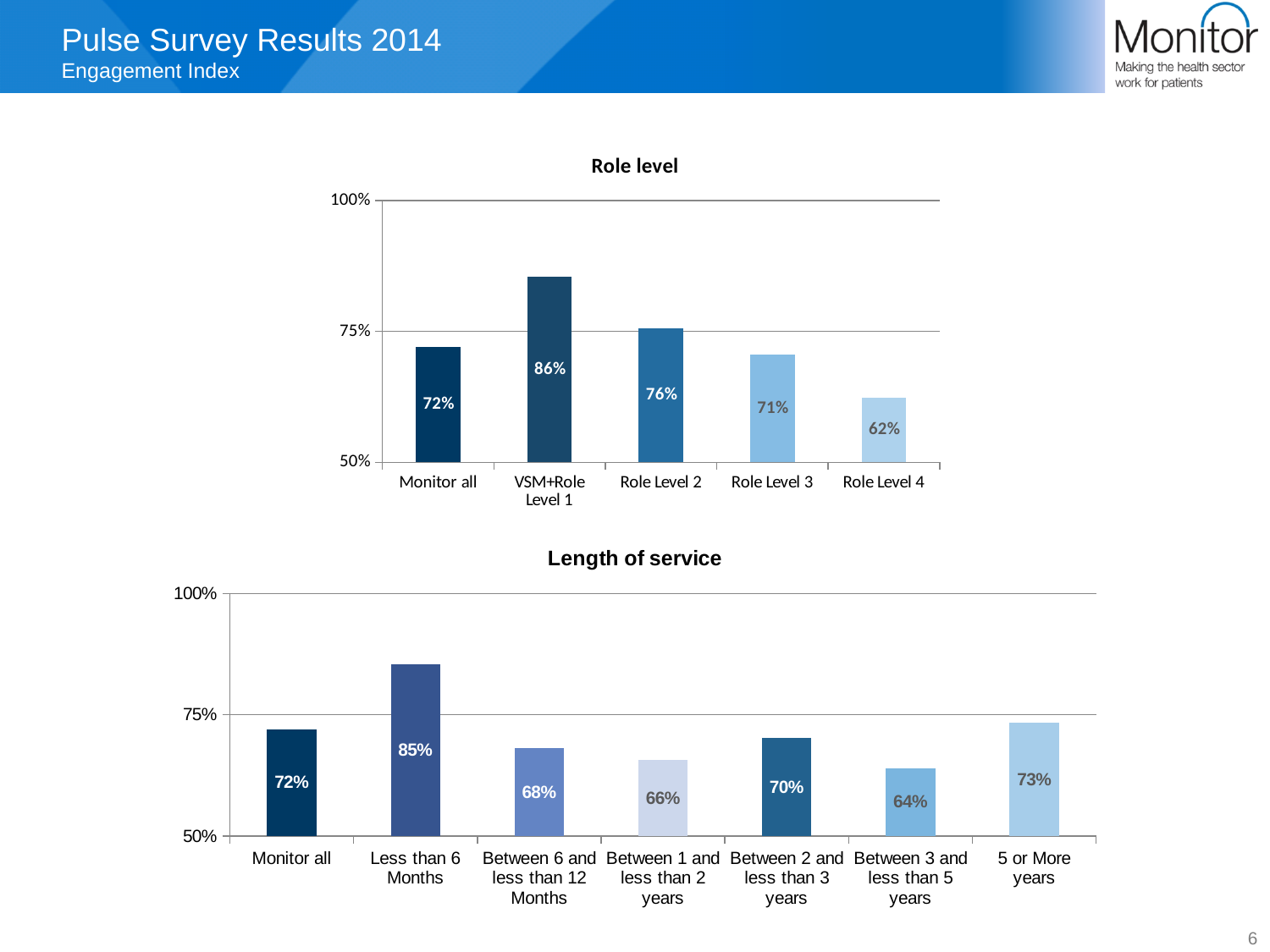
What kind of chart is the Length of service chart? Bar chart In the Length of service chart, what is the value for Between 3 and less than 5 years? 64% In the Length of service chart, which category has the highest value? Less than 6 Months In the Role level chart, which category has the lowest value? Role Level 4 In the Length of service chart, what is the difference between Less than 6 Months and Between 1 and less than 2 years? 19% In the Role level chart, what is the difference between Role Level 2 and Role Level 3? 5% In the Role level chart, what is the value for VSM+Role Level 1? 86% In the Length of service chart, which is larger: 5 or More years or Between 2 and less than 3 years? 5 or More years What is the title of the top chart on the slide? Role level In the Length of service chart, how many categories are shown on the x axis? 7 In the Role level chart, is the value for Role Level 4 greater or less than 75%? less In the Role level chart, how many bars are plotted? 5